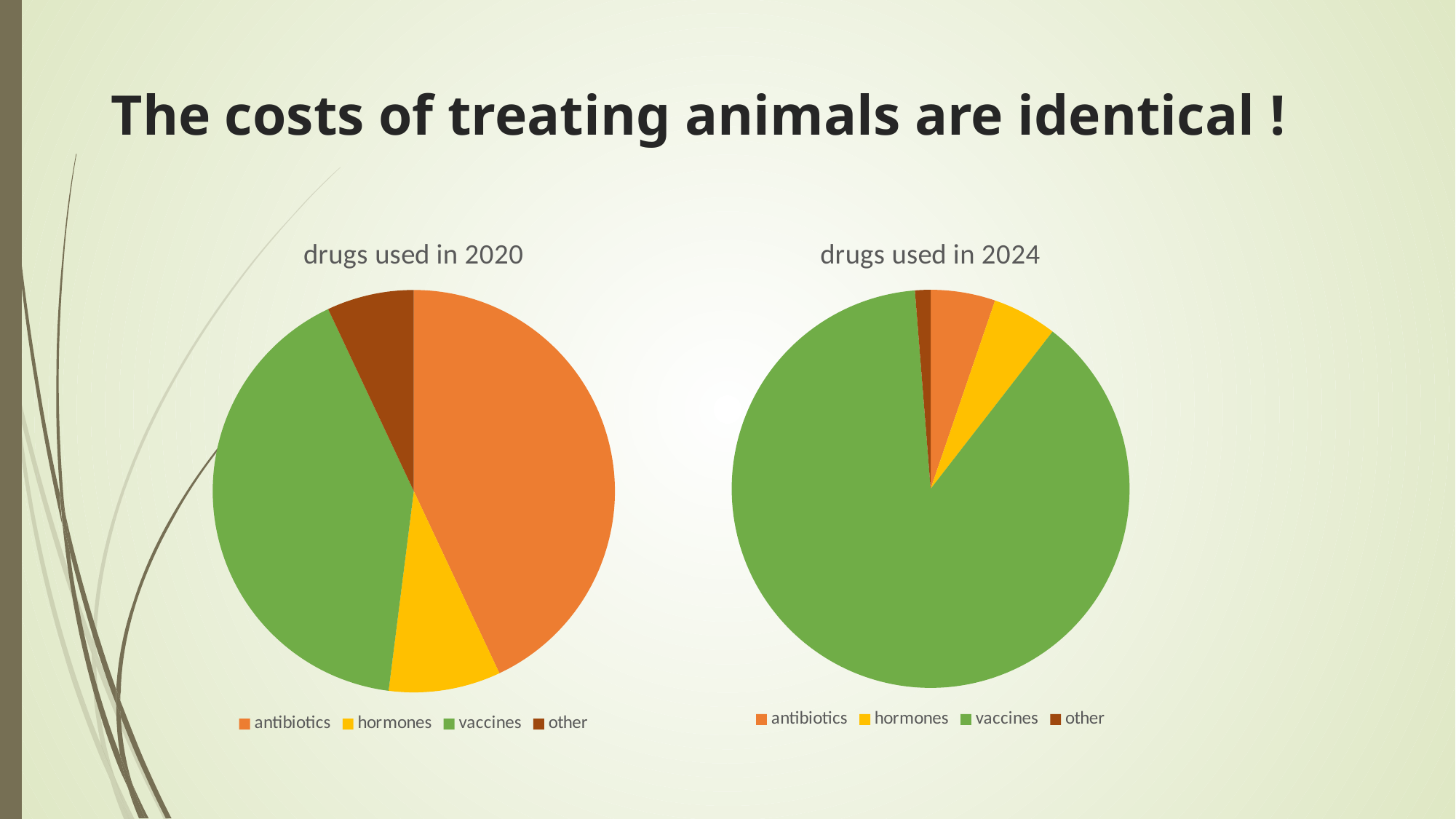
In the 'drugs used in 2024' chart, which category has the smallest slice? other How many slices does the 'drugs used in 2020' pie chart have? 4 In the 'drugs used in 2024' chart, which slice is larger: vaccines or antibiotics? vaccines In the 'drugs used in 2020' chart, which slice is larger: antibiotics or hormones? antibiotics In the 'drugs used in 2024' chart, which category has the largest slice? vaccines What is the title of the left chart on the slide? drugs used in 2020 What kind of chart is the 'drugs used in 2020' chart? pie chart In the 'drugs used in 2020' chart, which slice is larger: vaccines or other? vaccines What kind of chart is the 'drugs used in 2024' chart? pie chart How many categories does the legend of the 'drugs used in 2024' chart list? 4 In the 'drugs used in 2020' chart, which colour represents hormones? yellow